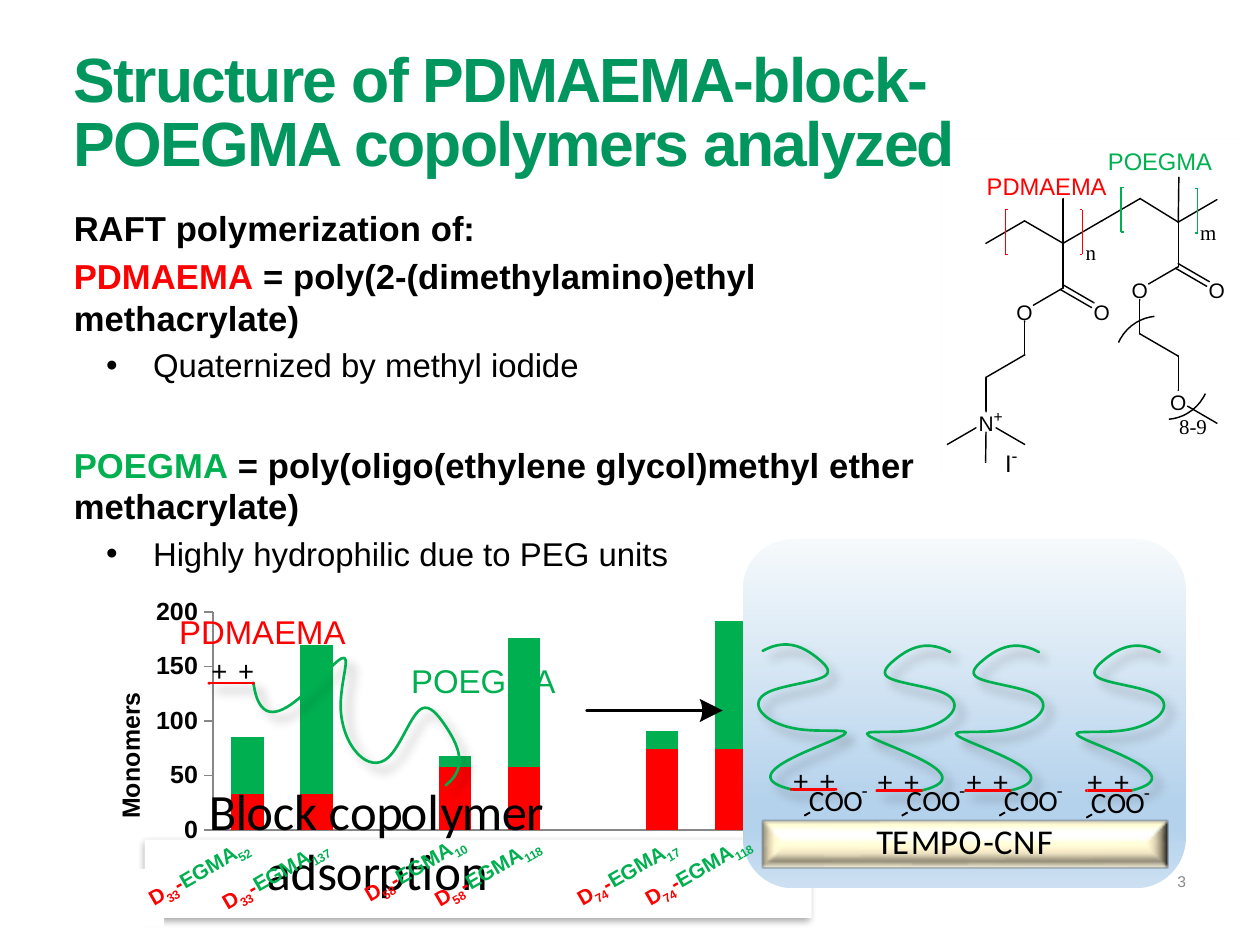
Which two components are stacked in each bar of the chart? PDMAEMA and POEGMA Which bar is taller, D33-EGMA137 or D33-EGMA52? D33-EGMA137 Is the total number of monomers for D74-EGMA17 greater or less than 100? less Which copolymer has the tallest bar in the chart? D74-EGMA118 Is the PDMAEMA (red) portion of the D74-EGMA118 bar greater or less than 50? greater How many block copolymers (bars) are plotted in the bar chart? 6 Is the total number of monomers for D33-EGMA137 greater or less than 150? greater Which colour represents POEGMA in the bar chart? green What is the label of the vertical axis of the bar chart? Monomers Which copolymer has the shortest bar in the chart? D58-EGMA10 What kind of chart is shown at the bottom of the slide? stacked bar chart